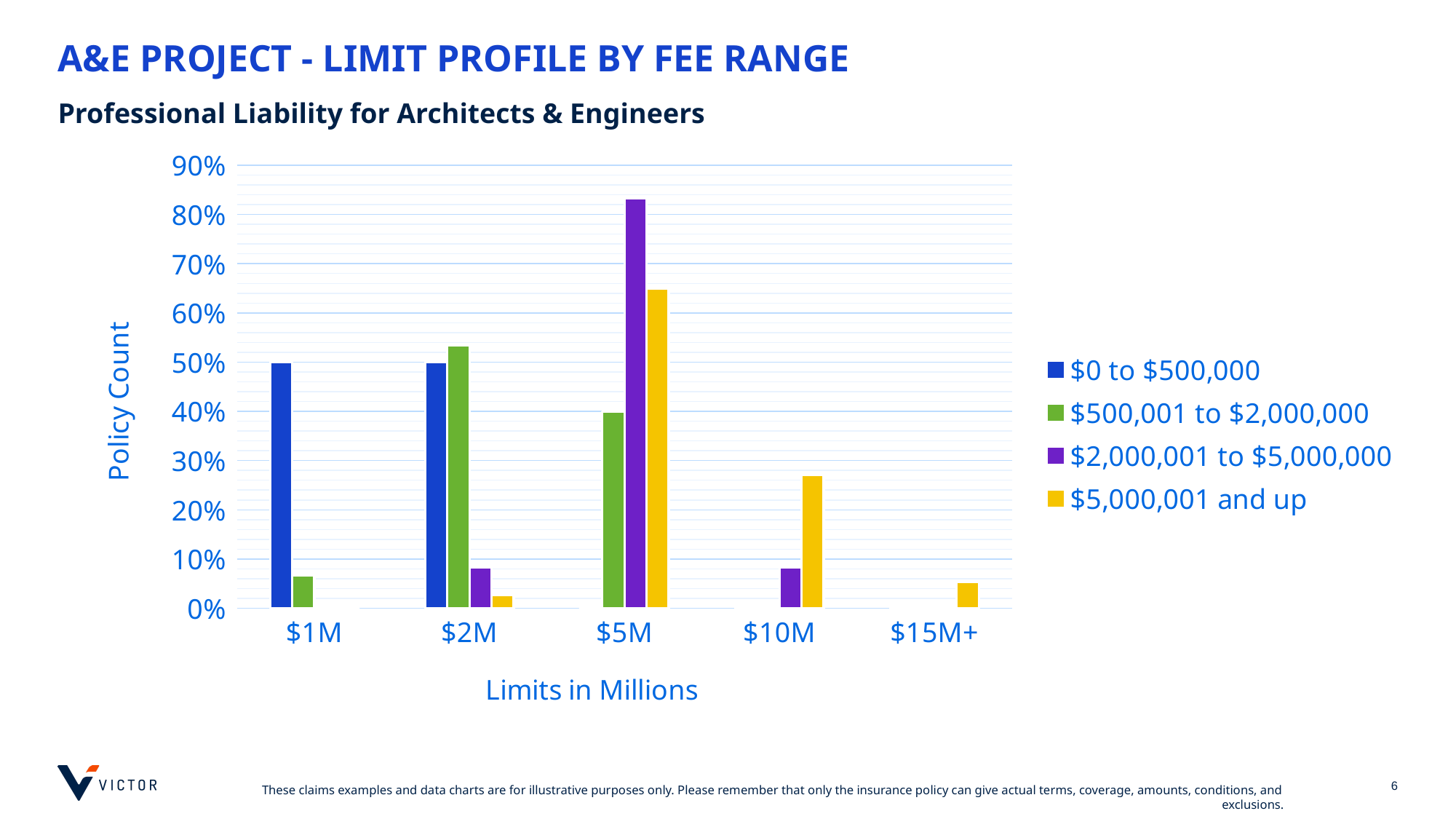
At the $5M limit, which series has the larger value: $2,000,001 to $5,000,000 or $5,000,001 and up? $2,000,001 to $5,000,000 At the $2M limit, which series has the larger value: $500,001 to $2,000,000 or $2,000,001 to $5,000,000? $500,001 to $2,000,000 How many limit categories are shown on the x axis? 5 What kind of chart is shown on the slide? bar chart Is the value for the $2,000,001 to $5,000,000 series at $5M greater or less than 80%? greater What is the value for the $0 to $500,000 series at the $1M limit? 50% What is the title of the vertical axis? Policy Count For the $5,000,001 and up series, which limit has the highest value? $5M How many series does the legend list? 4 For the $2,000,001 to $5,000,000 series, which limit has the highest value? $5M Is the value for the $5,000,001 and up series at $10M greater or less than 30%? less Is the value for the $5,000,001 and up series at $5M greater or less than 60%? greater